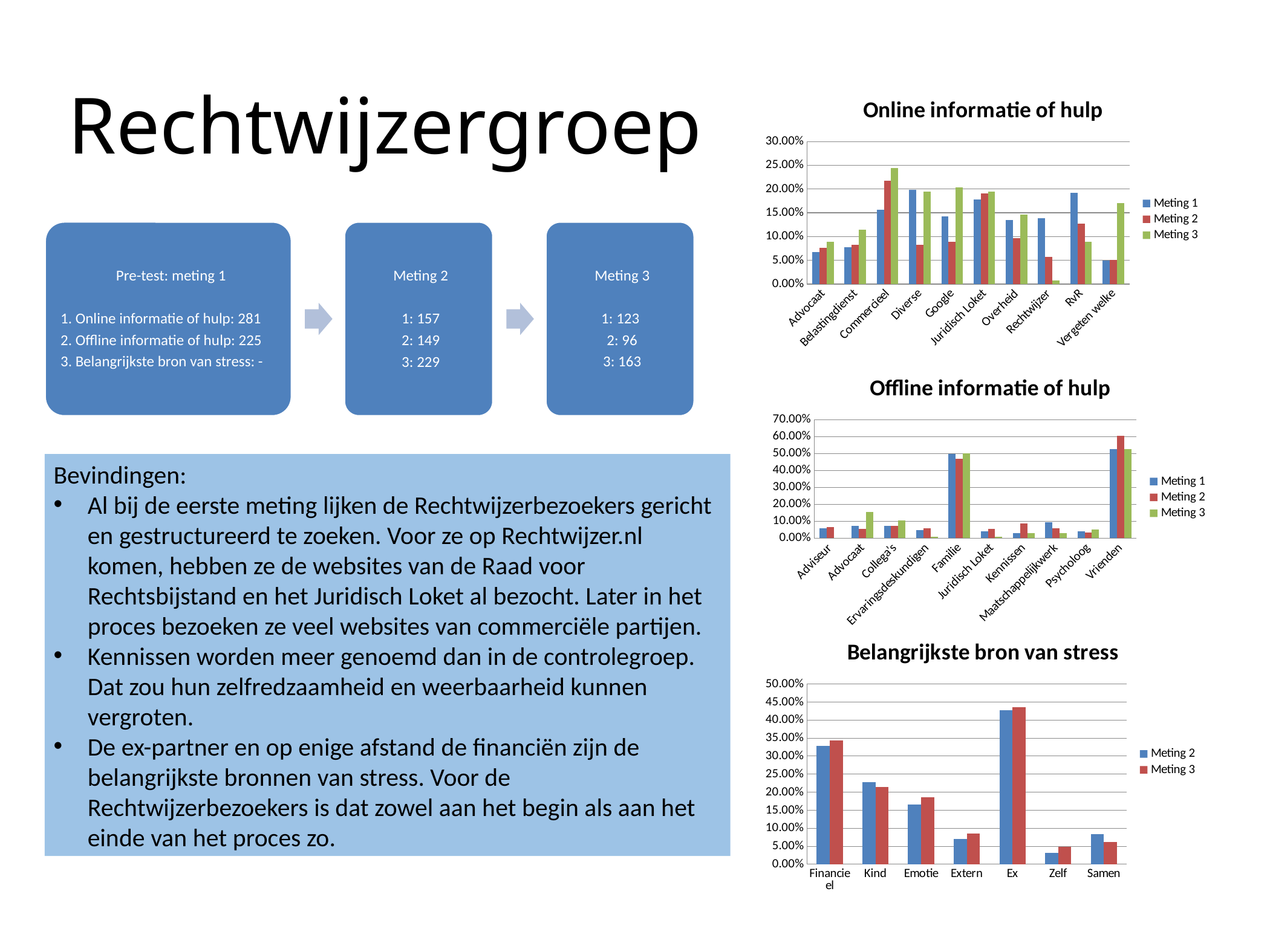
How many series does the legend of the 'Online informatie of hulp' chart list? 3 In the 'Belangrijkste bron van stress' chart, which category has the highest value for Meting 3? Ex In the 'Offline informatie of hulp' chart, which category has the highest value for Meting 2? Vrienden In the 'Belangrijkste bron van stress' chart, which category has the lowest value for Meting 2? Zelf How many series does the legend of the 'Belangrijkste bron van stress' chart list? 2 In the 'Belangrijkste bron van stress' chart, is the Meting 2 value for Ex greater or less than 40.00%? greater In the 'Belangrijkste bron van stress' chart, is the Meting 3 value for Financieel greater or less than 30.00%? greater How many categories are shown on the x axis of the 'Belangrijkste bron van stress' chart? 7 What kind of chart is the 'Offline informatie of hulp' chart? bar chart In the 'Belangrijkste bron van stress' chart, for Emotie, which is larger: Meting 2 or Meting 3? Meting 3 In the 'Online informatie of hulp' chart, which category has the highest value for Meting 3? Commercieel In the 'Online informatie of hulp' chart, is the Meting 3 value for Commercieel greater or less than 20.00%? greater